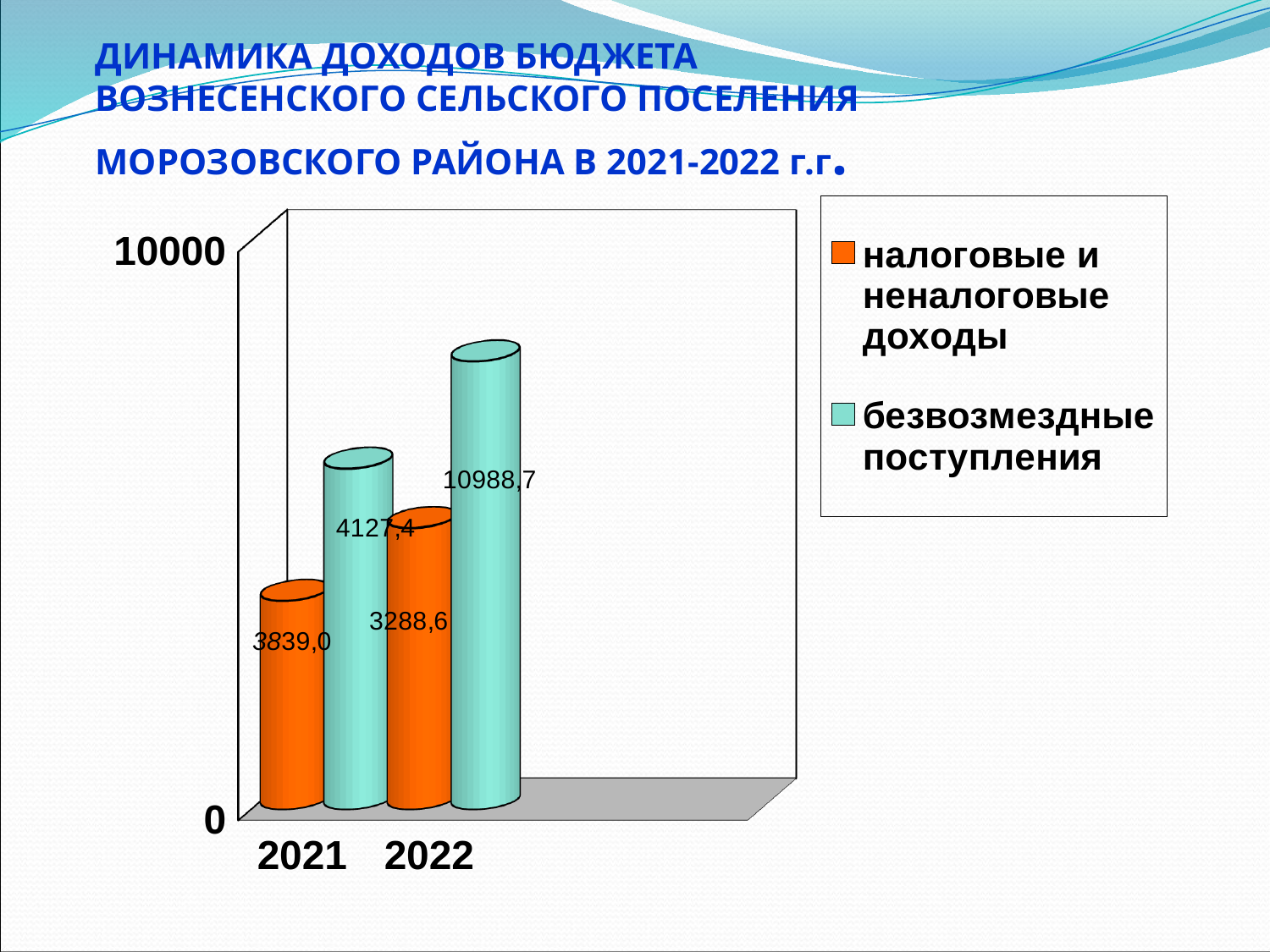
What is the value of налоговые и неналоговые доходы for 2022? 3288,6 Do the values for безвозмездные поступления rise or fall from 2021 to 2022? rise Which bar has the highest value on the chart? безвозмездные поступления, 2022 What kind of chart is shown on the slide? bar chart What is the difference between налоговые и неналоговые доходы in 2021 and in 2022? 550,4 How many series does the legend list? 2 What is the value of безвозмездные поступления for 2021? 4127,4 What is the value of безвозмездные поступления for 2022? 10988,7 Which is larger in 2022: налоговые и неналоговые доходы or безвозмездные поступления? безвозмездные поступления What is the value of налоговые и неналоговые доходы for 2021? 3839,0 What is the difference between безвозмездные поступления in 2022 and in 2021? 6861,3